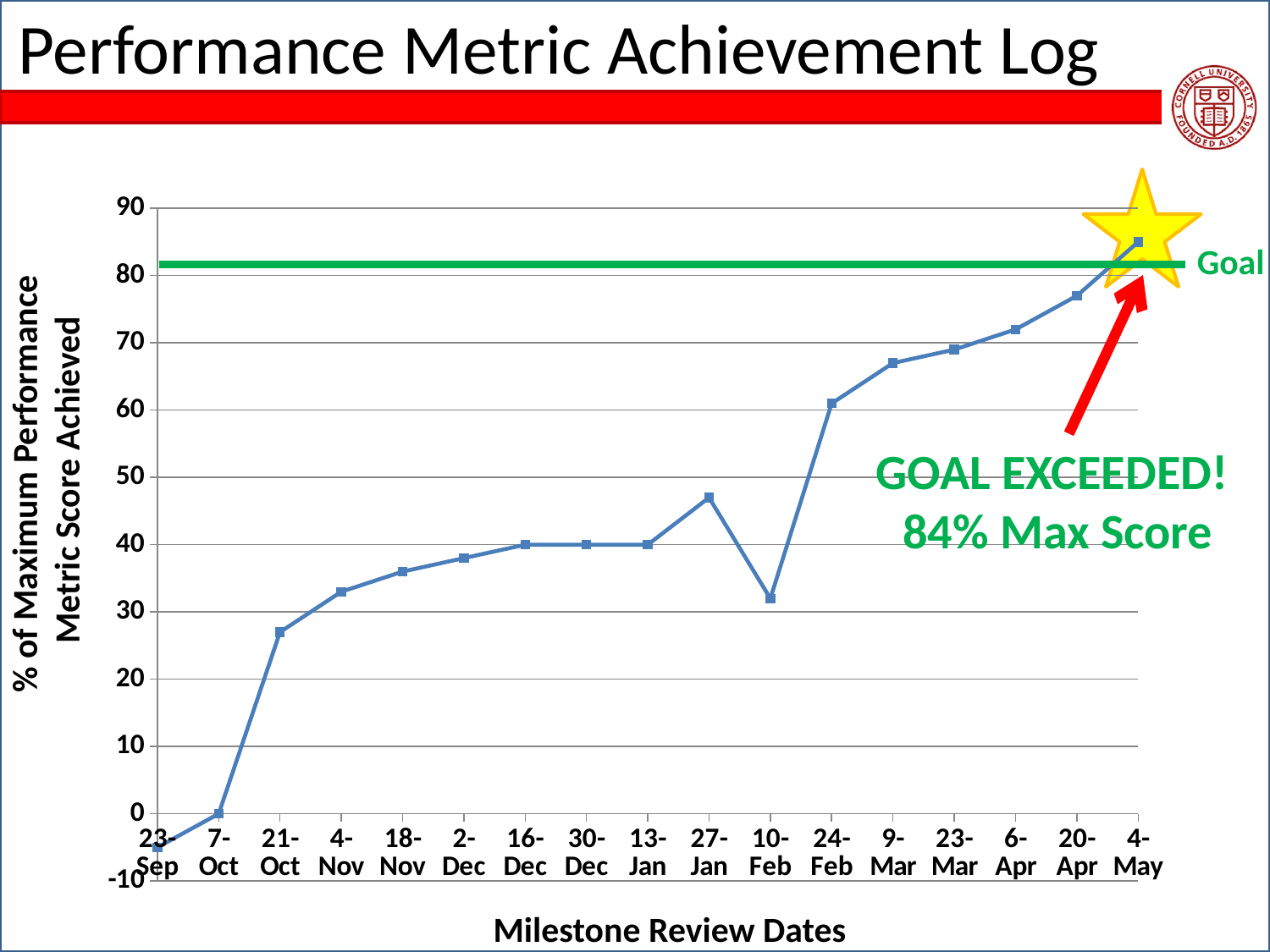
Which milestone review date has the highest metric score? 4-May What is the title of the x axis? Milestone Review Dates Which has the larger metric score, 27-Jan or 10-Feb? 27-Jan Is the value for 10-Feb greater or less than 40? less Is the value for 21-Oct greater or less than 30? less What is the metric score on 16-Dec? 40 How many milestone review dates are plotted on the x axis? 17 Do the metric scores generally rise or fall from 23-Sep to 4-May? rise Which milestone review date has the lowest metric score? 23-Sep What is the metric score on 7-Oct? 0 What kind of chart is shown on the slide? line chart Is the value for 20-Apr greater or less than 70? greater